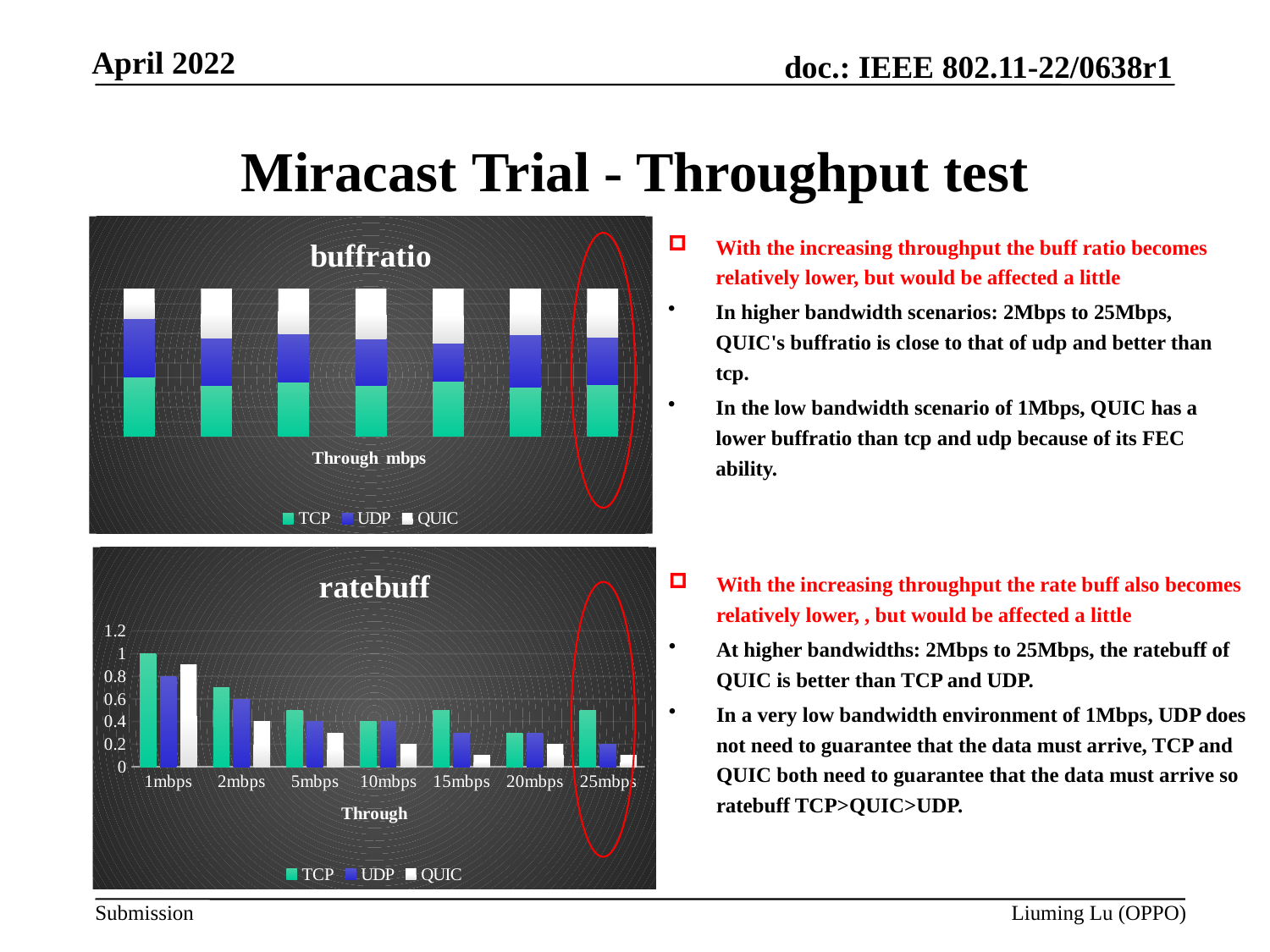
In the ratebuff chart, at 1mbps, which is larger: TCP or UDP? TCP In the ratebuff chart, which category has the highest TCP value? 1mbps In the ratebuff chart, is the QUIC value at 25mbps greater or less than 0.2? less In the ratebuff chart, at 1mbps, which is larger: QUIC or UDP? QUIC How many series does the legend of the buffratio chart list? 3 In the ratebuff chart, do the TCP values generally rise or fall from 1mbps to 25mbps? fall How many categories are shown on the x axis of the ratebuff chart? 7 In the ratebuff chart, is the QUIC value at 2mbps greater or less than 0.6? less How many series does the legend of the ratebuff chart list? 3 In the ratebuff chart, what is the TCP value at 1mbps? 1 What is the x-axis title of the ratebuff chart? Through What kind of chart is the ratebuff chart? bar chart